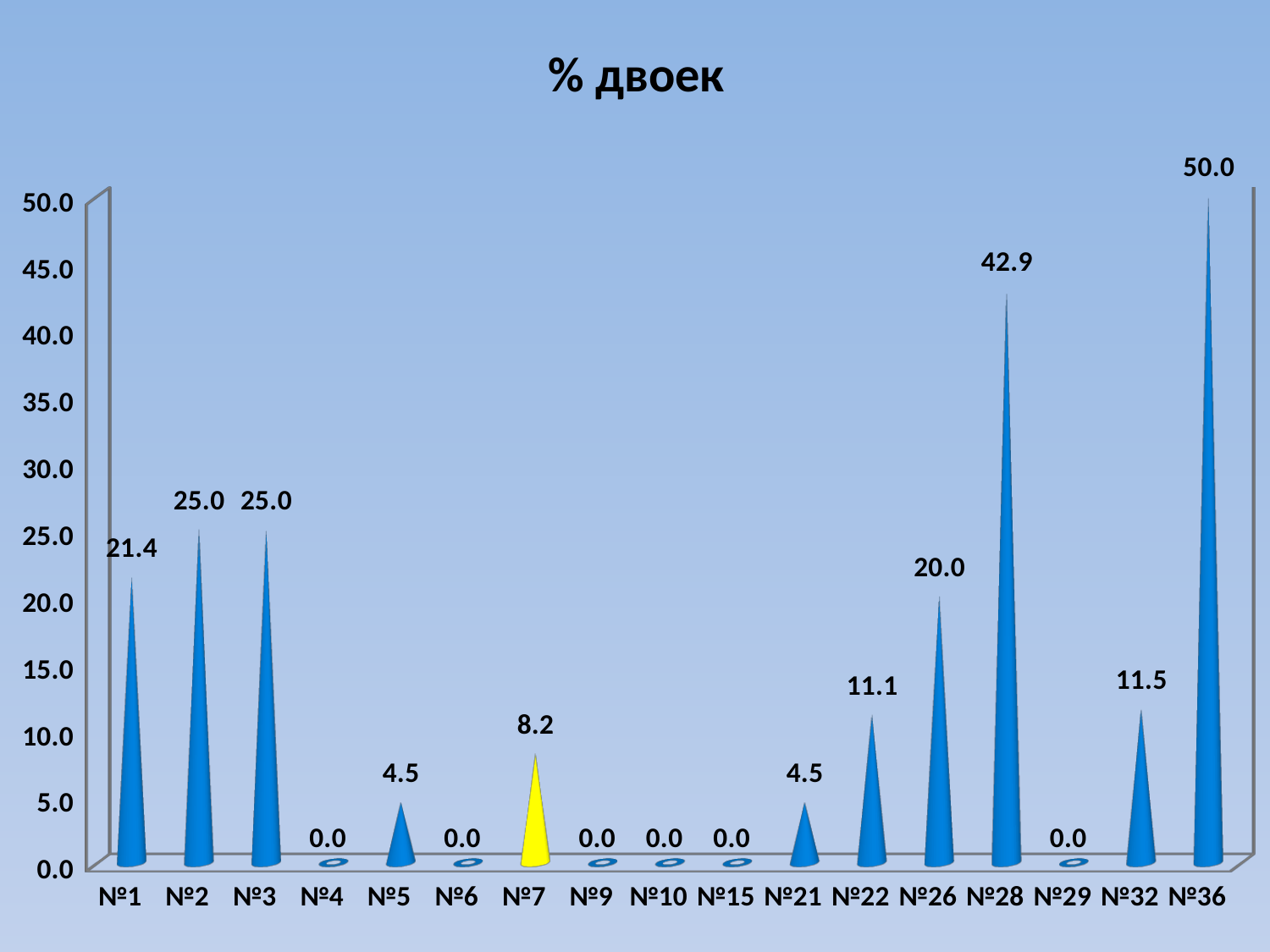
How many categories have a value of 0.0? 6 Which category has the highest value? №36 Which is larger, the value for №26 or the value for №32? №26 What is the value for №22? 11.1 Which category's bar is coloured yellow instead of blue? №7 How many categories are shown on the x axis? 17 What is the value for №28? 42.9 What is the value for №7? 8.2 What is the difference between the values for №36 and №28? 7.1 Which is larger, the value for №7 or the value for №21? №7 What is the difference between the values for №2 and №1? 3.6 What kind of chart is shown on the slide? Bar chart